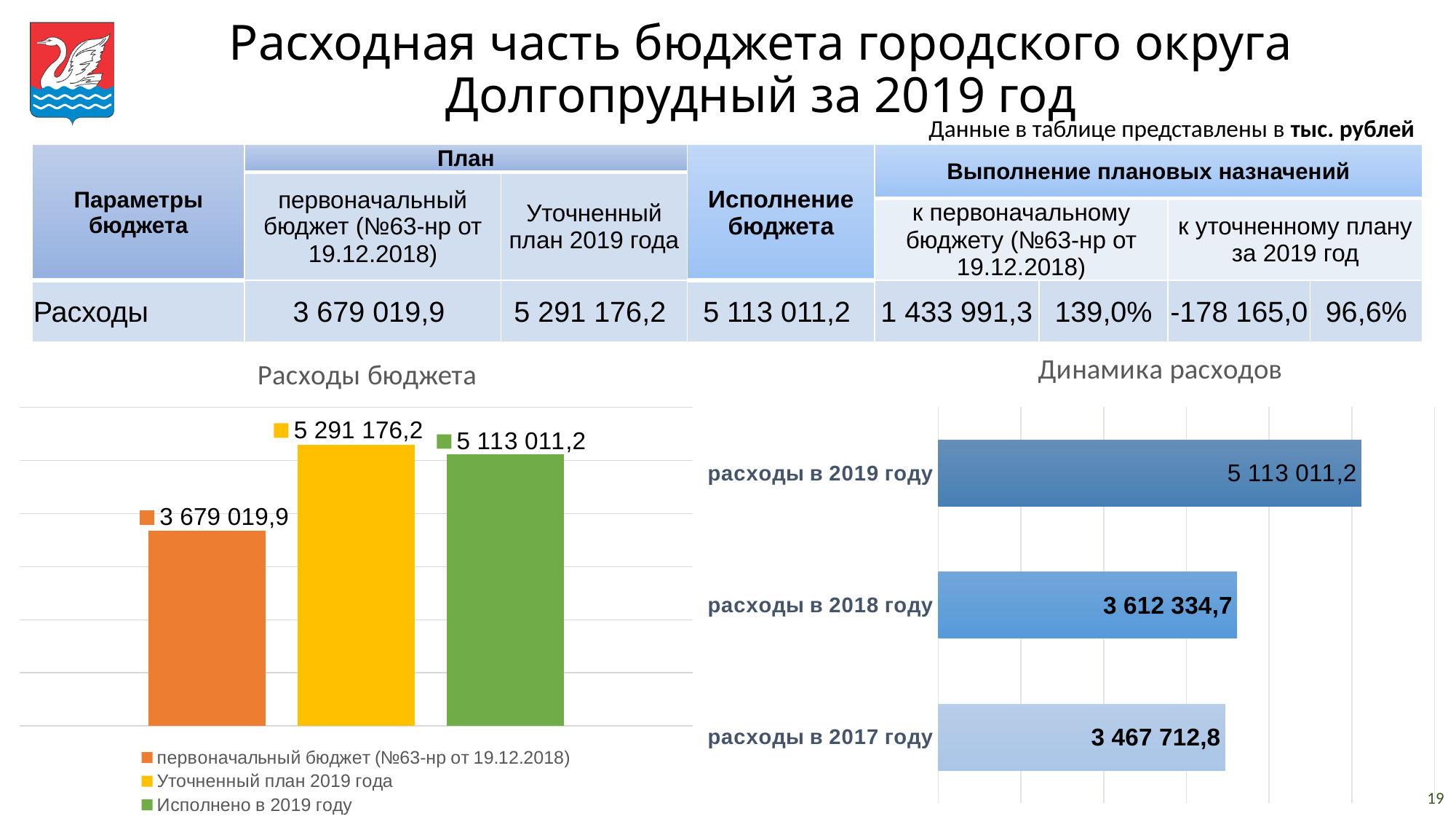
In the chart titled "Расходы бюджета", what is the value for "первоначальный бюджет (№63-нр от 19.12.2018)"? 3 679 019,9 In the chart titled "Расходы бюджета", what is the value for "Уточненный план 2019 года"? 5 291 176,2 What kind of chart is the chart titled "Динамика расходов"? Bar chart In the chart titled "Расходы бюджета", what is the difference between "Уточненный план 2019 года" and "Исполнено в 2019 году"? 178 165,0 In the chart titled "Расходы бюджета", what colour is the bar for "Исполнено в 2019 году"? Green In the chart titled "Динамика расходов", what is the difference between "расходы в 2019 году" and "расходы в 2018 году"? 1 500 676,5 In the chart titled "Динамика расходов", what is the value for "расходы в 2018 году"? 3 612 334,7 In the chart titled "Расходы бюджета", how many series does the legend list? 3 In the chart titled "Расходы бюджета", which series has the lowest value? первоначальный бюджет (№63-нр от 19.12.2018) In the chart titled "Расходы бюджета", which series has the highest value? Уточненный план 2019 года In the chart titled "Динамика расходов", which category has the highest value? расходы в 2019 году In the chart titled "Динамика расходов", what is the value for "расходы в 2017 году"? 3 467 712,8